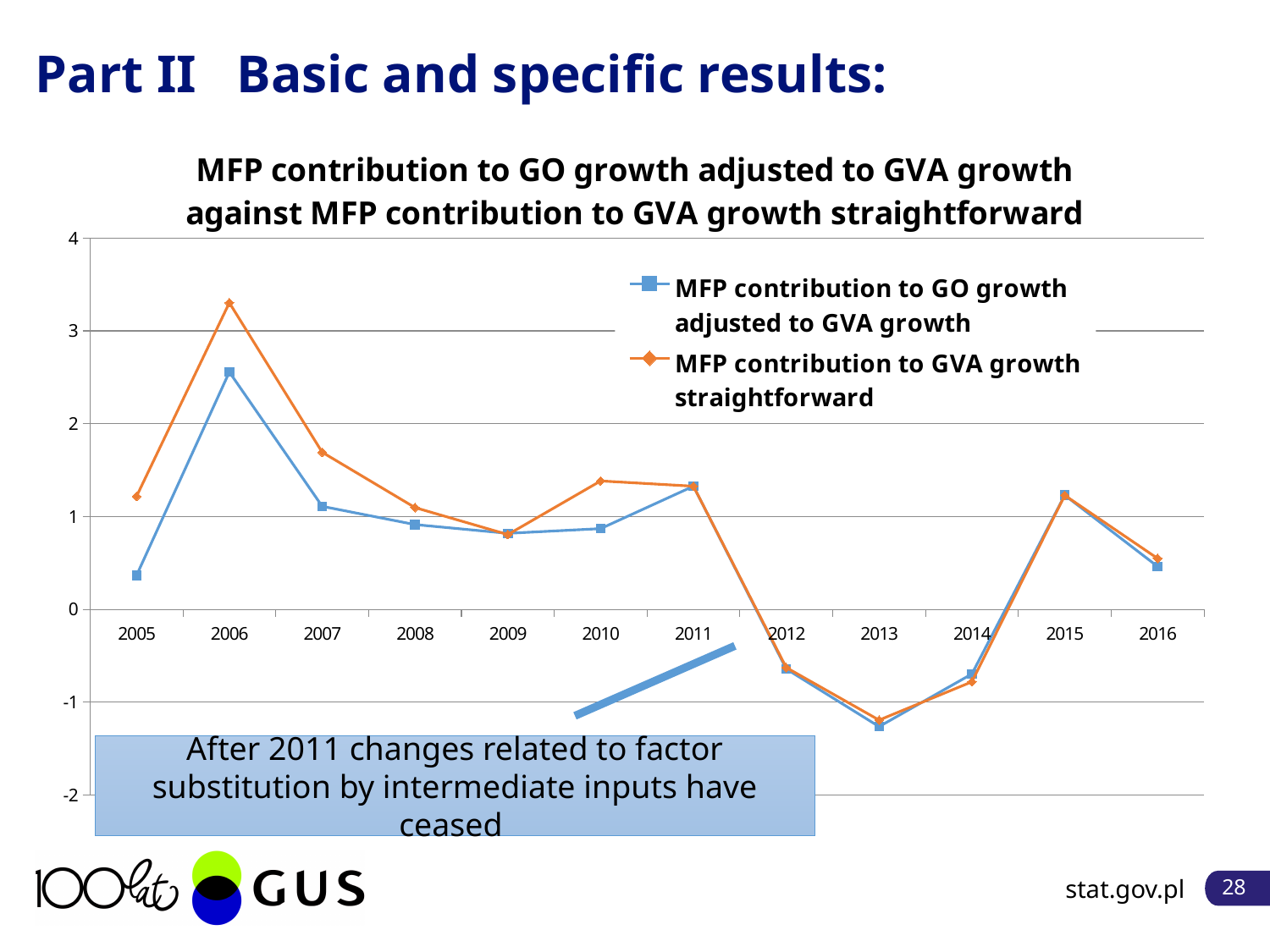
Is the 2005 value for 'MFP contribution to GO growth adjusted to GVA growth' greater or less than 1? less Is the 2013 value for 'MFP contribution to GO growth adjusted to GVA growth' greater or less than -1? less Is the 2006 value for 'MFP contribution to GVA growth straightforward' greater or less than 3? greater How many series does the legend list? 2 In which year does the 'MFP contribution to GVA growth straightforward' series reach its highest value? 2006 In 2006, which series has the larger value: 'MFP contribution to GO growth adjusted to GVA growth' or 'MFP contribution to GVA growth straightforward'? MFP contribution to GVA growth straightforward Does the 'MFP contribution to GO growth adjusted to GVA growth' series rise or fall from 2006 to 2009? fall How many years are plotted along the x axis? 12 Which colour is used for the 'MFP contribution to GVA growth straightforward' series? orange In which year does the 'MFP contribution to GO growth adjusted to GVA growth' series reach its lowest value? 2013 What kind of chart is shown on the slide? line chart